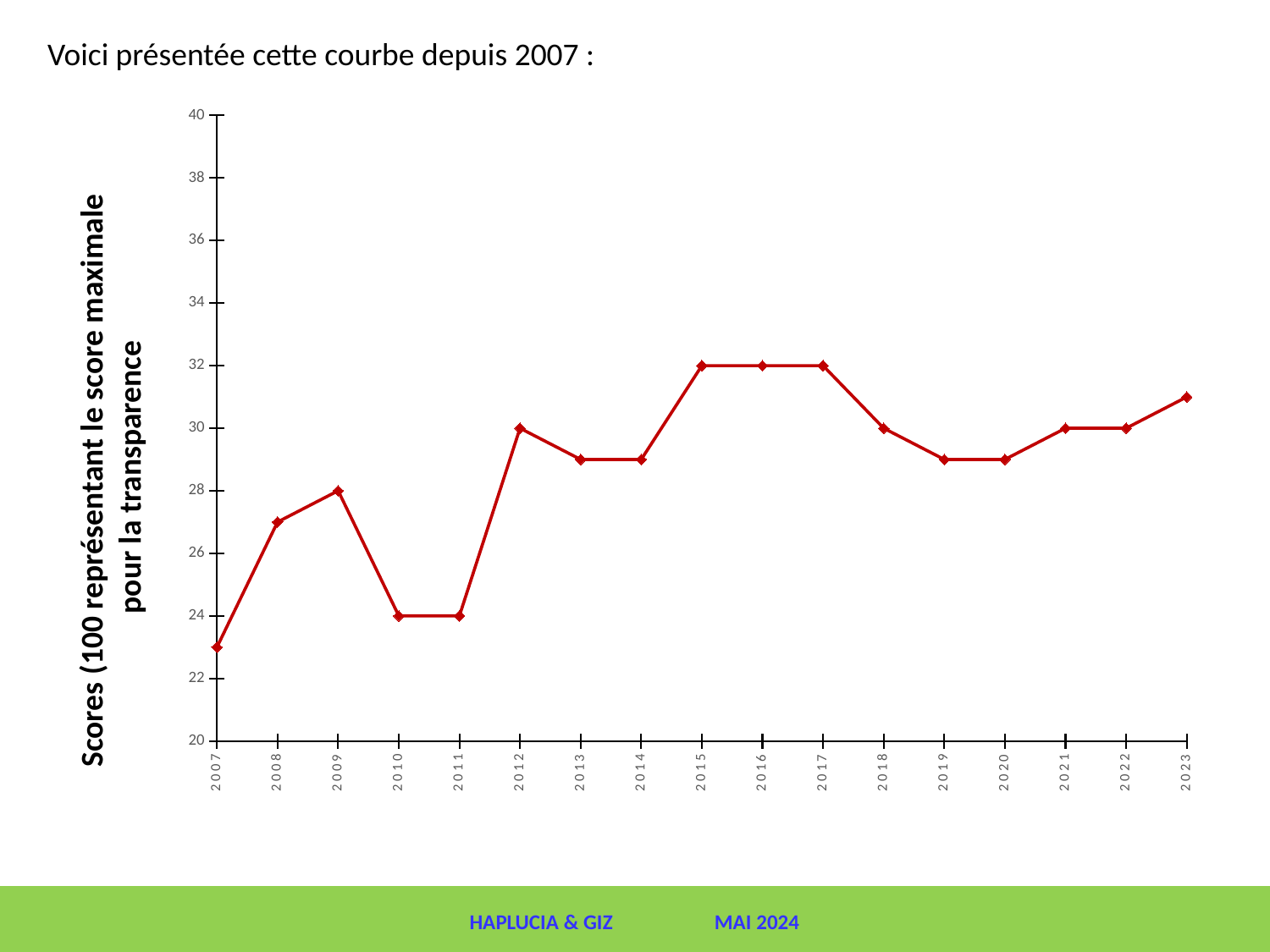
What type of chart is shown on the slide? line chart What is the difference between the score in 2015 and the score in 2010? 8 Which year has the lowest score? 2007 How many years are plotted on the x axis? 17 Does the score rise or fall from 2007 to 2009? rise What is the score for 2010? 24 What is the score for 2009? 28 What is the highest score reached on the chart? 32 Is the value for 2023 greater or less than 30? greater What is the score for 2015? 32 What is the score for 2012? 30 Which year has the larger score, 2012 or 2010? 2012